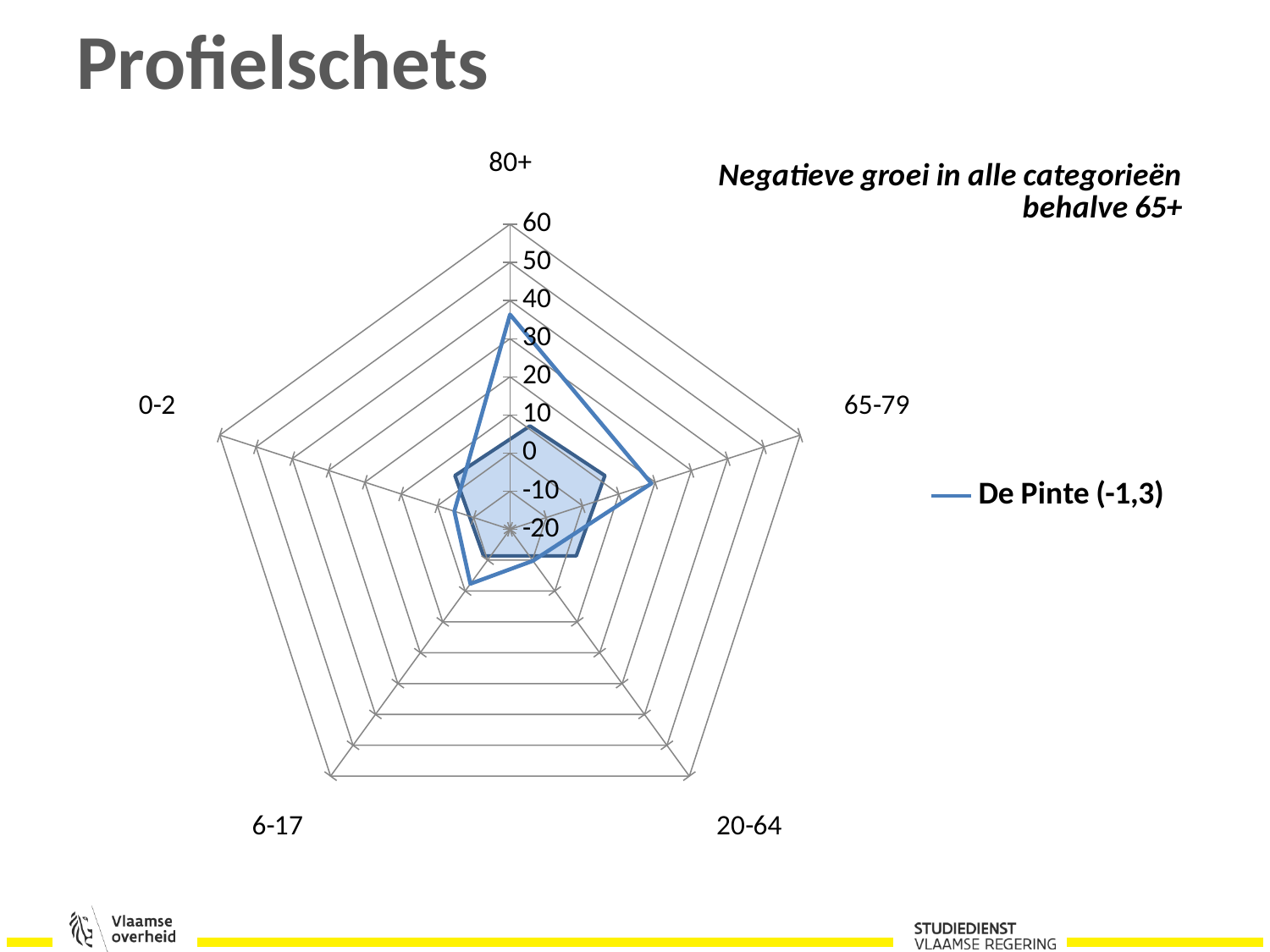
Is the value for 80+ greater or less than 30? greater How many age categories are plotted on the radar chart? 5 What is the highest value shown on the radar chart's axis scale? 60 Which age category has the lowest value for De Pinte? 20-64 Which age category has the highest value for De Pinte? 80+ What is the series name shown in the legend? De Pinte (-1,3) How many series does the legend list? 1 Which is larger for De Pinte, the value for 80+ or the value for 65-79? 80+ Is the value for 80+ greater or less than 40? less Is the value for 65-79 greater or less than 10? greater What kind of chart is shown on the slide? Radar chart